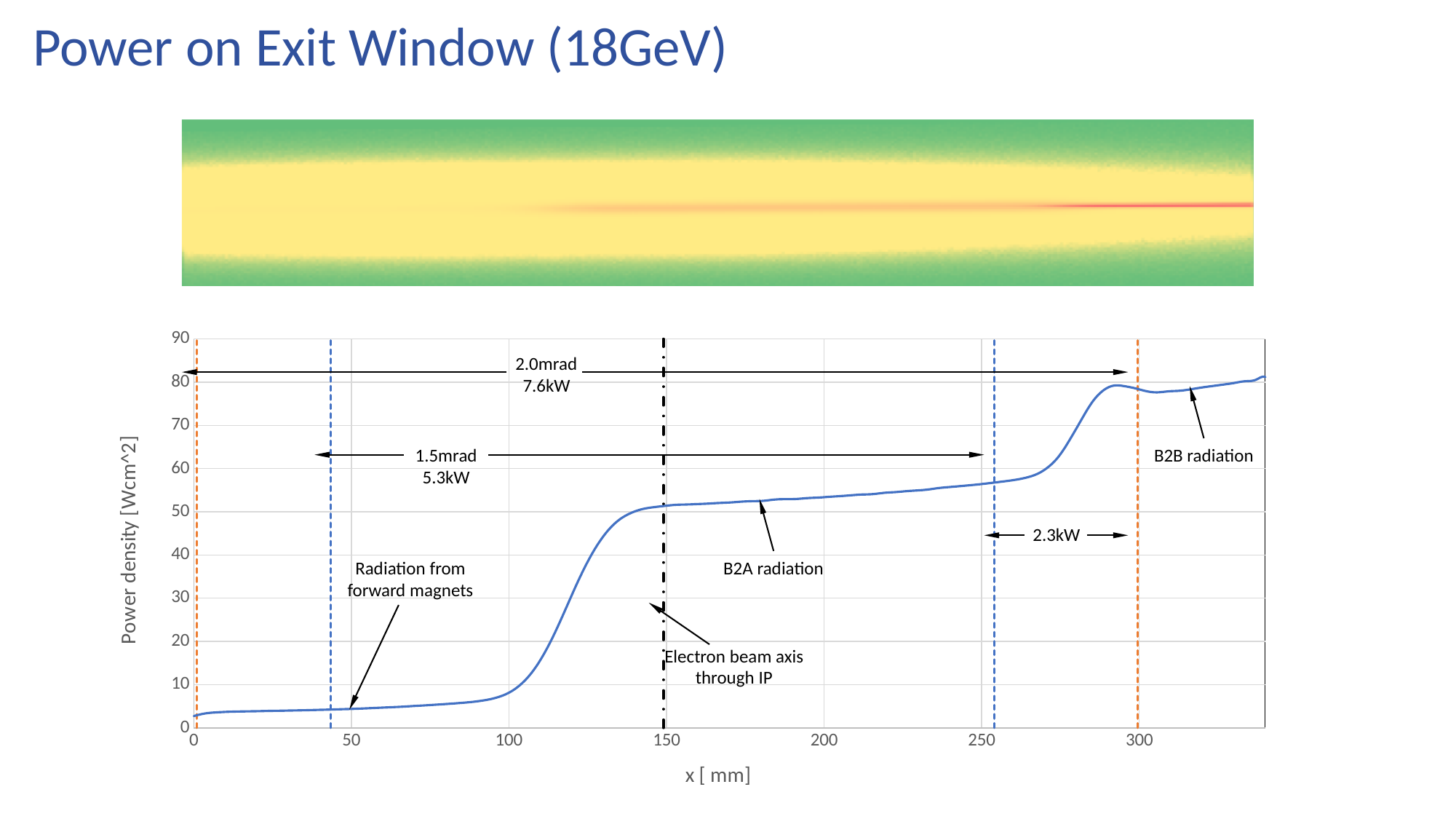
Is the power density at x = 200 mm greater or less than 50? greater Which is larger, the power density at x = 300 mm or at x = 50 mm? x = 300 mm Does the power density generally rise or fall as x increases along the x axis? rise What power is annotated for the 2.0mrad range on the chart? 7.6kW What is the label of the x axis of the chart? x [ mm] What kind of chart is shown on the slide? line chart Is the power density at x = 300 mm greater or less than 70? greater Is the power density at x = 100 mm greater or less than 10? less What is the label of the y axis of the chart? Power density [Wcm^2] Which is larger, the power density at x = 100 mm or at x = 200 mm? x = 200 mm